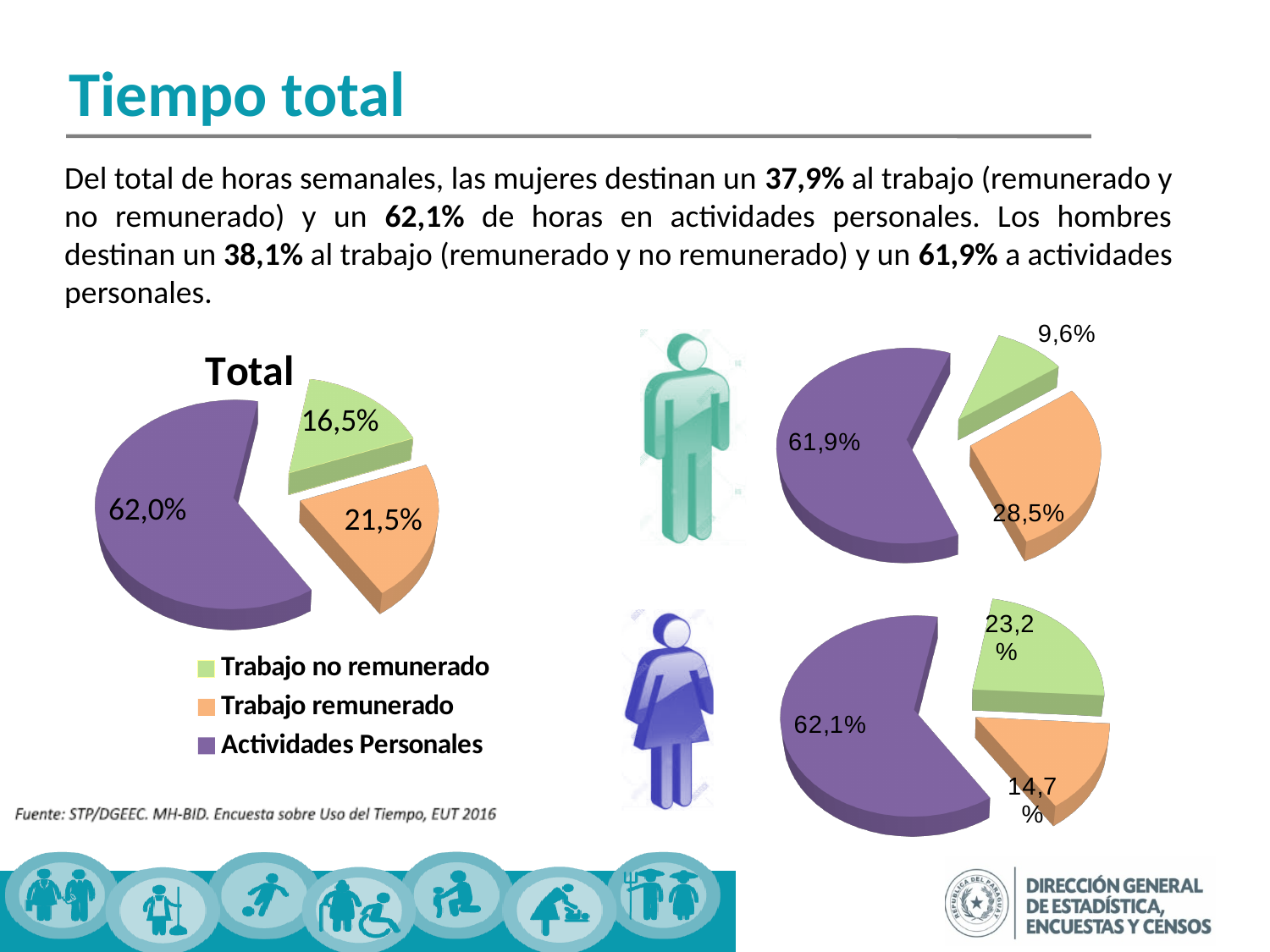
In the bottom-right pie chart (next to the female figure), which is larger: Trabajo no remunerado or Trabajo remunerado? Trabajo no remunerado In the 'Total' pie chart, what is the difference between the Trabajo remunerado and Trabajo no remunerado shares? 5,0% In the 'Total' pie chart, what share is shown for Trabajo no remunerado? 16,5% In the 'Total' pie chart, which category has the largest slice? Actividades Personales In the top-right pie chart (next to the male figure), which category has the smallest slice? Trabajo no remunerado In the 'Total' pie chart, what share is shown for Trabajo remunerado? 21,5% In the bottom-right pie chart (next to the female figure), what share is shown for Trabajo no remunerado? 23,2% In the top-right pie chart (next to the male figure), what share is shown for Trabajo no remunerado? 9,6% In the 'Total' pie chart, what share is shown for Actividades Personales? 62,0% In the bottom-right pie chart (next to the female figure), what share is shown for Actividades Personales? 62,1% How many categories does the legend list for the pie charts? 3 In the top-right pie chart (next to the male figure), what share is shown for Trabajo remunerado? 28,5%